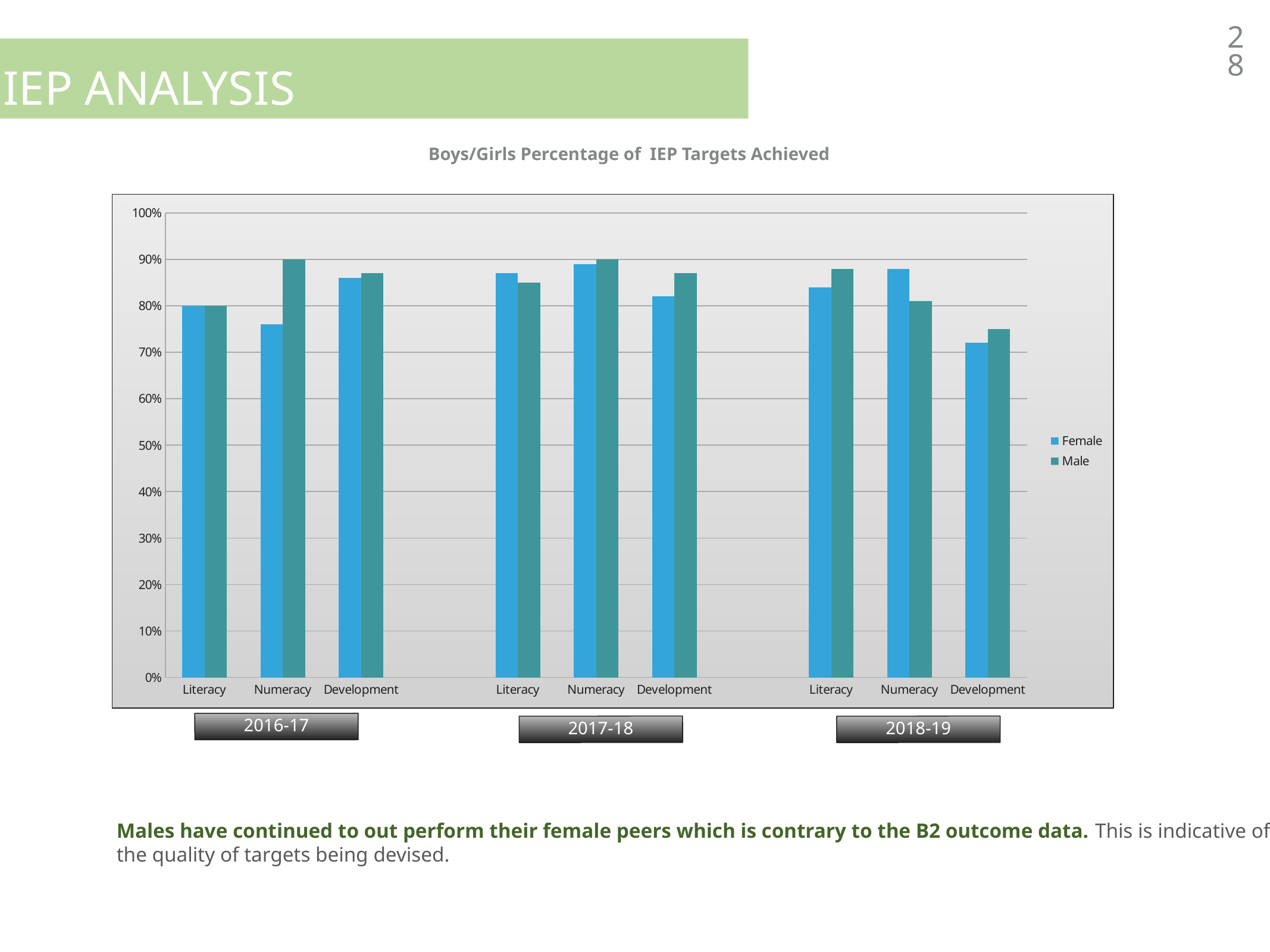
Is the Female value for Numeracy in 2016-17 greater or less than 80%? less How many school years are shown along the x axis of the chart? 3 Is the Female value for Literacy in 2017-18 greater or less than 80%? greater How many series does the legend list? 2 What is the Male value for Numeracy in 2016-17? 90% For Numeracy in 2018-19, which is larger, the Female or the Male value? Female What kind of chart is shown on the slide? bar chart For Numeracy in 2016-17, which is larger, the Female or the Male value? Male Is the Female value for Development in 2018-19 greater or less than 80%? less What is the title of the chart? Boys/Girls Percentage of IEP Targets Achieved Does the Female value for Development rise or fall from 2016-17 to 2018-19? fall What is the Female value for Literacy in 2016-17? 80%